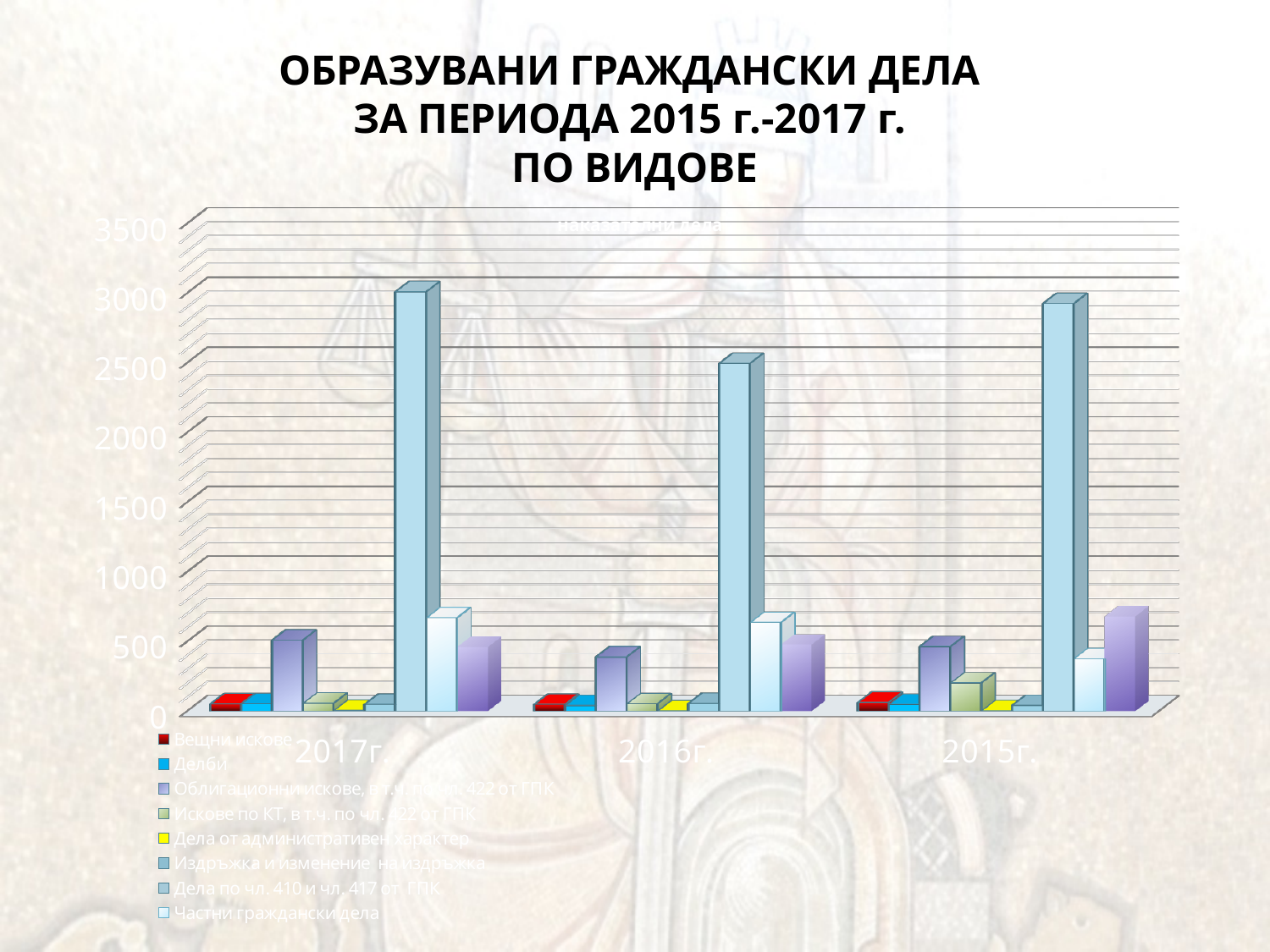
What kind of chart is shown on the slide? bar chart Is the value for Дела по чл. 410 и чл. 417 от ГПК in 2015г. greater or less than 2500? greater What is the title of the slide? ОБРАЗУВАНИ ГРАЖДАНСКИ ДЕЛА ЗА ПЕРИОДА 2015 г.-2017 г. ПО ВИДОВЕ Which is larger: the value for Дела по чл. 410 и чл. 417 от ГПК in 2017г. or in 2016г.? 2017г. Is the value for Дела по чл. 410 и чл. 417 от ГПК in 2016г. greater or less than 2000? greater Is the value for Облигационни искове, в т.ч. по чл. 422 от ГПК in 2017г. greater or less than 1000? less Which series has the tallest bar in the 2016г. group? Дела по чл. 410 и чл. 417 от ГПК How many year groups are shown on the x axis of the chart? 3 What colour represents Вещни искове in the legend? red Which series has the tallest bar in the 2017г. group? Дела по чл. 410 и чл. 417 от ГПК